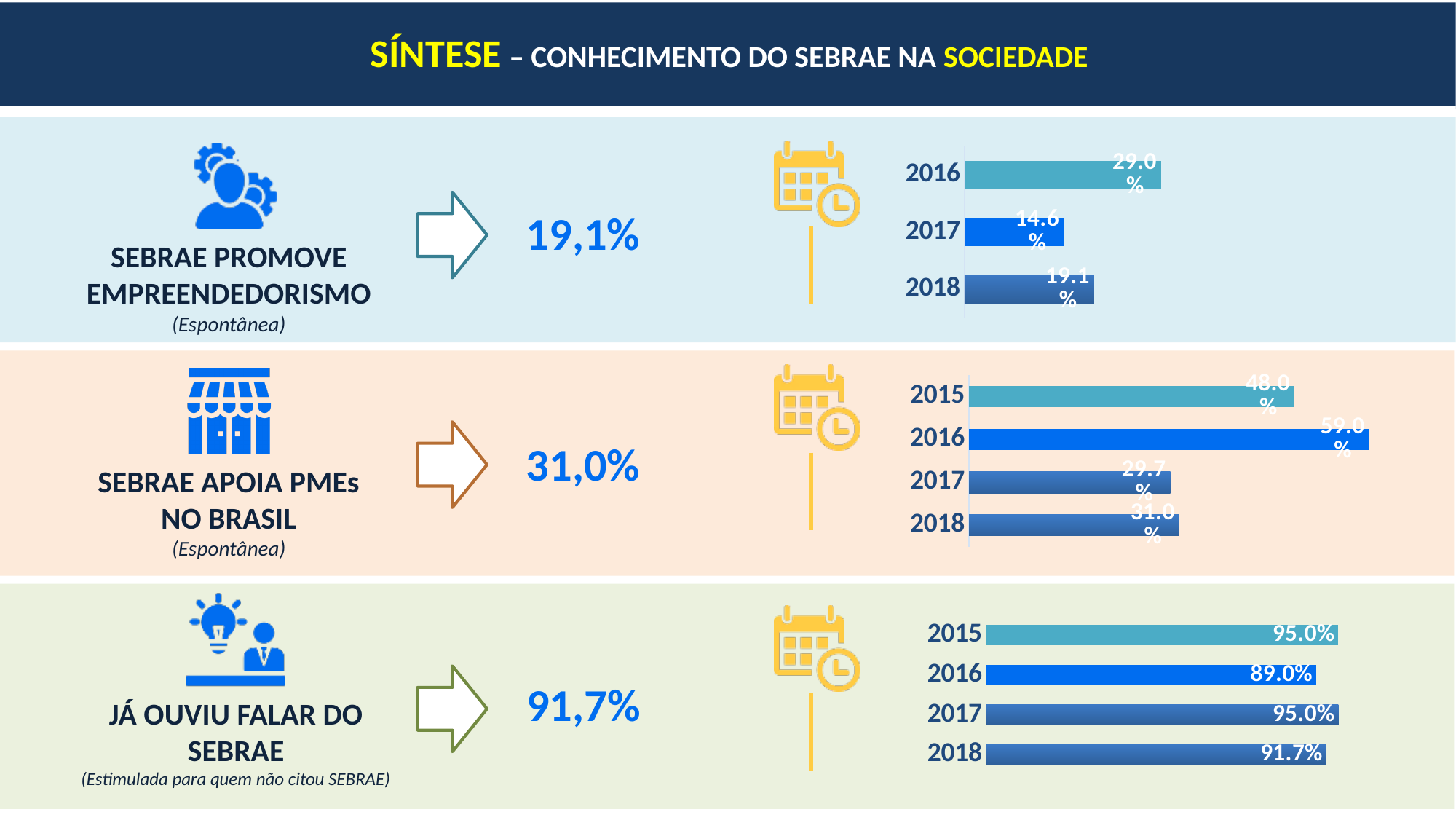
In the middle chart (SEBRAE APOIA PMEs NO BRASIL), which is larger, the value for 2015 or the value for 2018? 2015 In the top chart (SEBRAE PROMOVE EMPREENDEDORISMO), how many years are plotted? 3 In the bottom chart (JÁ OUVIU FALAR DO SEBRAE), what is the value for 2018? 91.7% In the middle chart (SEBRAE APOIA PMEs NO BRASIL), what is the value for 2016? 59.0% In the top chart (SEBRAE PROMOVE EMPREENDEDORISMO), do the values rise or fall from 2016 to 2017? Fall In the middle chart (SEBRAE APOIA PMEs NO BRASIL), what is the difference between the 2016 and 2015 values? 11.0% In the top chart (SEBRAE PROMOVE EMPREENDEDORISMO), which year has the highest value? 2016 What type of chart is used in the bottom section (JÁ OUVIU FALAR DO SEBRAE)? Bar chart In the top chart (SEBRAE PROMOVE EMPREENDEDORISMO), what is the value for 2017? 14.6% In the middle chart (SEBRAE APOIA PMEs NO BRASIL), which year has the lowest value? 2017 In the bottom chart (JÁ OUVIU FALAR DO SEBRAE), what is the difference between the 2017 and 2018 values? 3.3% In the bottom chart (JÁ OUVIU FALAR DO SEBRAE), which year has the lowest value? 2016